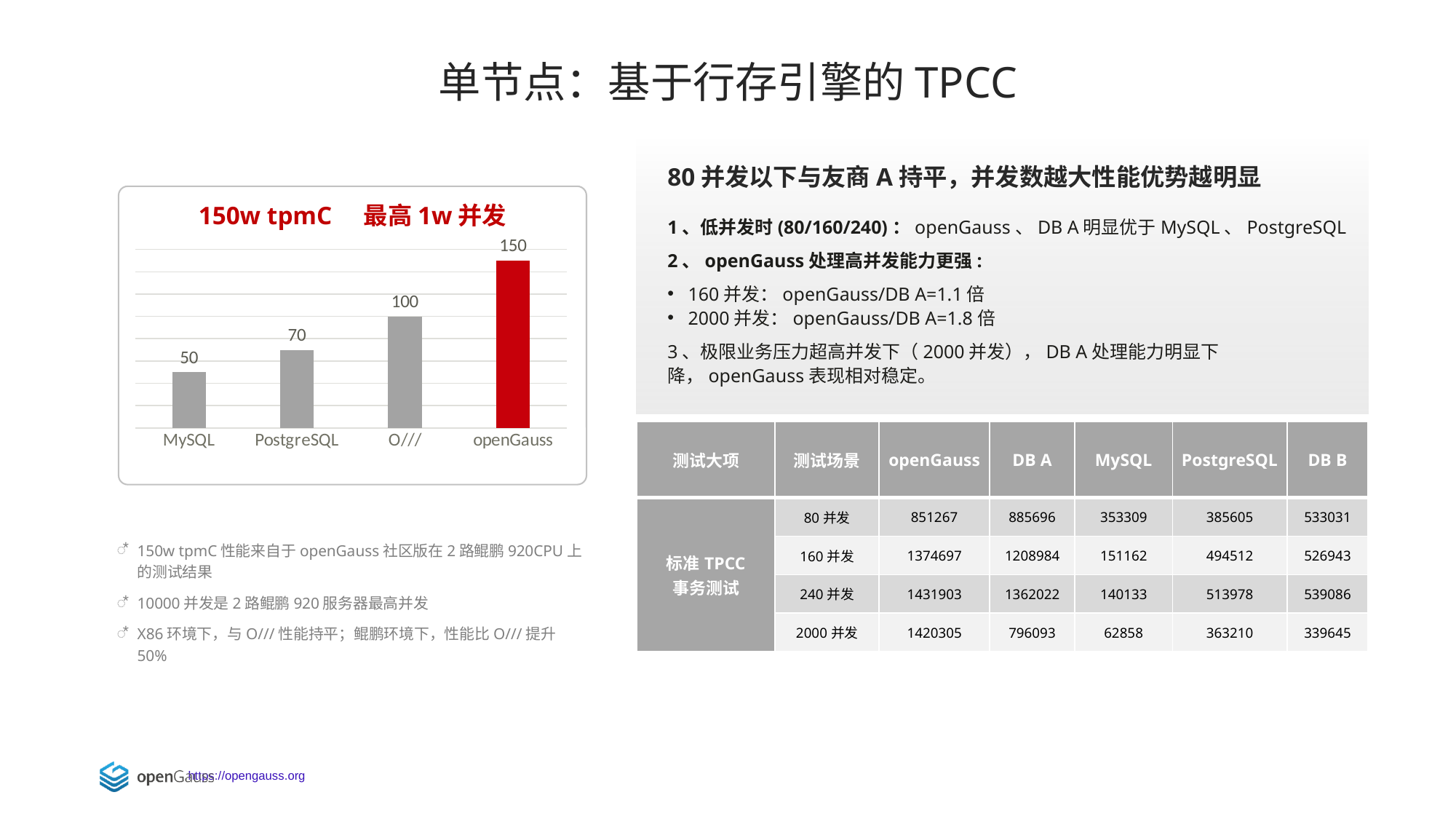
What is the value shown for MySQL in the bar chart? 50 Which category has the lowest value in the bar chart? MySQL What is the difference between the PostgreSQL and MySQL values in the bar chart? 20 Which category has the highest value in the bar chart? openGauss What kind of chart is shown on the slide? bar chart What is the value shown for PostgreSQL in the bar chart? 70 What is the difference between the openGauss and O/// values in the bar chart? 50 How many categories are shown in the bar chart? 4 What is the value shown for openGauss in the bar chart? 150 Which is larger in the bar chart, the value for PostgreSQL or the value for O///? O/// What is the value shown for O/// in the bar chart? 100 Which bar in the chart is coloured red? openGauss